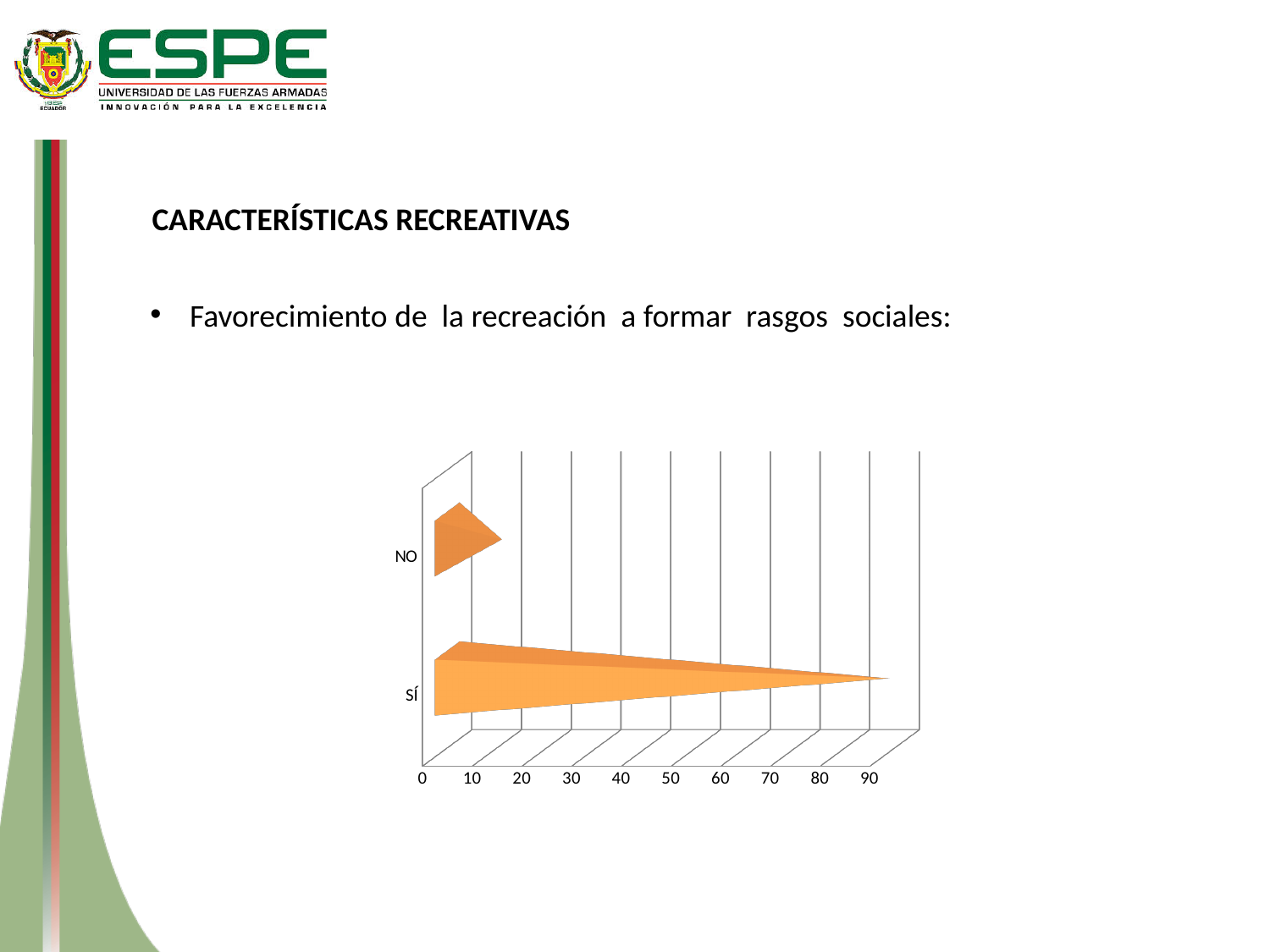
Which is larger, the value for SÍ or the value for NO? SÍ Is the value for SÍ greater or less than 80? greater Is the value for SÍ greater or less than 50? greater How many categories does the chart show? 2 What is the highest tick value shown on the horizontal axis? 90 Is the value for NO greater or less than 20? less What kind of chart is shown on the slide? bar chart Which category has the lowest value? NO Which category has the highest value? SÍ What colour are the bars in the chart? orange